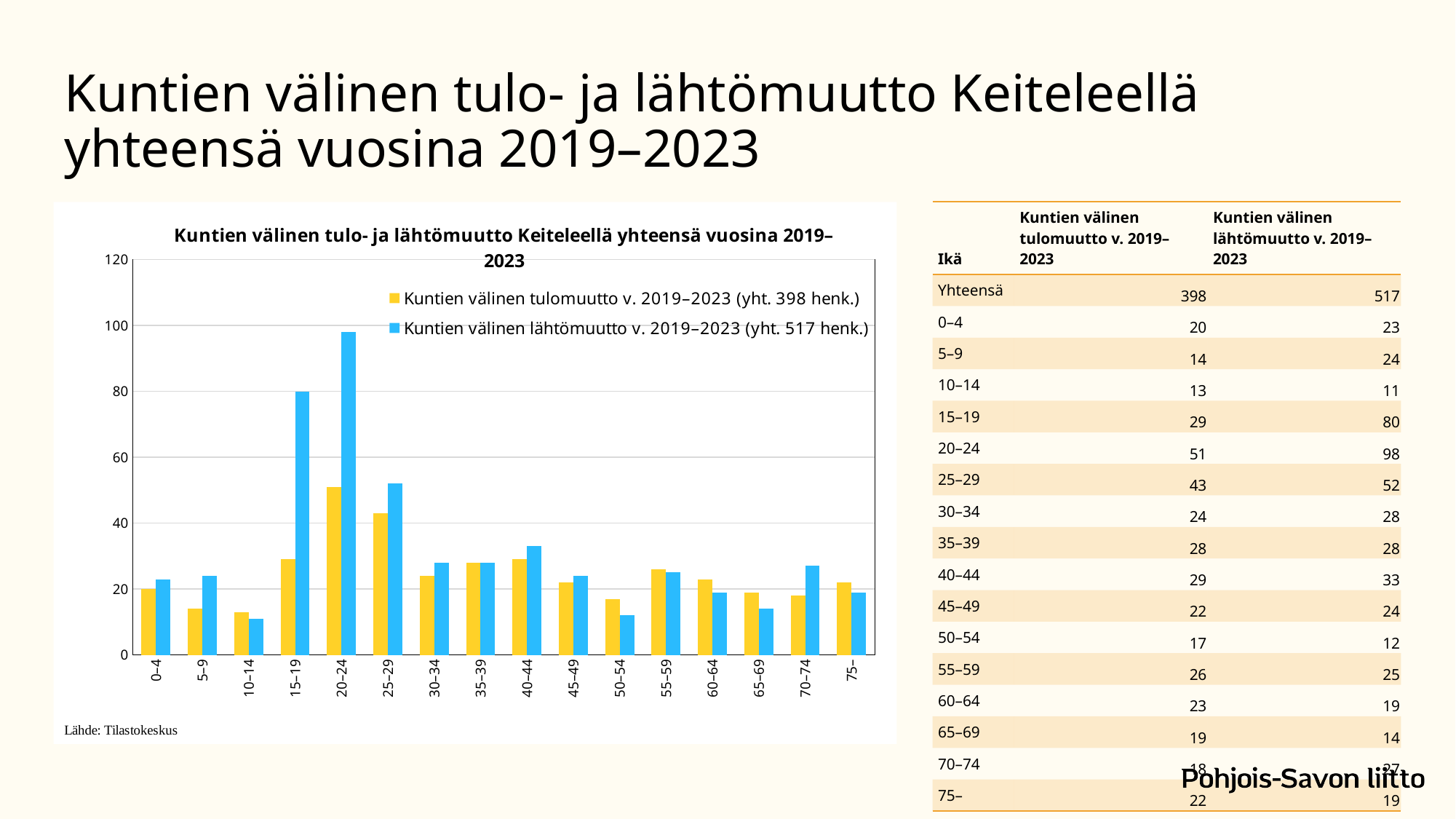
What is the value of Kuntien välinen lähtömuutto v. 2019–2023 for the 15–19 age group? 80 For the 50–54 age group, which is larger: tulomuutto or lähtömuutto? tulomuutto What kind of chart is shown on the slide? bar chart How many age groups are shown on the x axis of the chart? 16 According to the legend, what is the total number of persons for Kuntien välinen tulomuutto v. 2019–2023? 398 henk. How many series does the chart legend list? 2 What is the difference between lähtömuutto and tulomuutto for the 20–24 age group? 47 What is the value of Kuntien välinen lähtömuutto v. 2019–2023 for the 40–44 age group? 33 Is the value of lähtömuutto for the 20–24 age group greater or less than 80? greater Which age group has the highest value for Kuntien välinen lähtömuutto v. 2019–2023? 20–24 What is the value of Kuntien välinen tulomuutto v. 2019–2023 for the 20–24 age group? 51 Is the value of tulomuutto for the 15–19 age group greater or less than 40? less